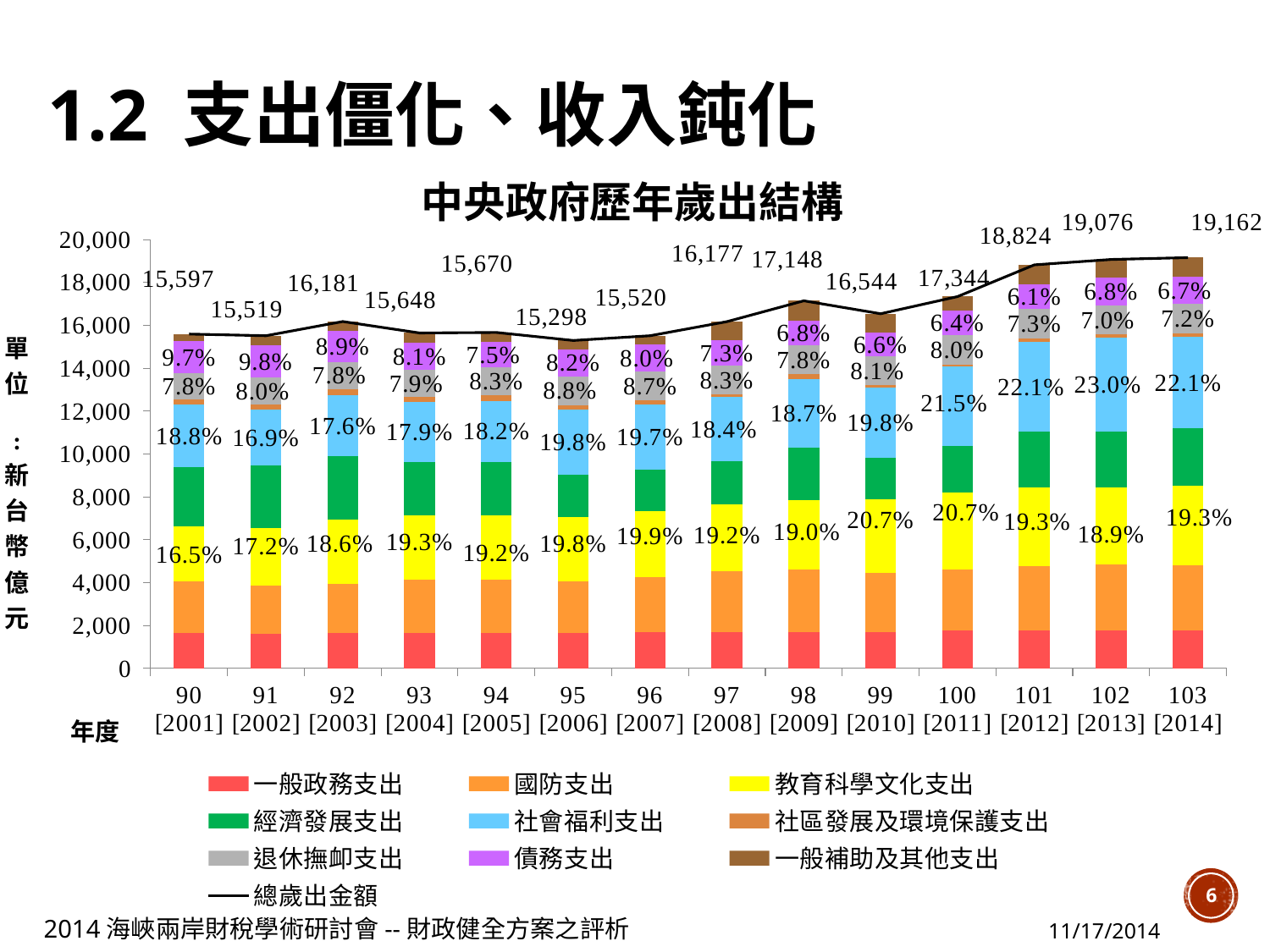
What is the difference between the total expenditure in 103 [2014] and in 90 [2001]? 3,565 What is the total expenditure (總歲出金額) shown for year 103 [2014]? 19,162 What share of expenditure does 社會福利支出 account for in year 102 [2013]? 23.0% Which year has the highest total expenditure (總歲出金額)? 103 [2014] How many entries does the legend list? 10 What kind of chart is this? Stacked bar chart with a line How many years are shown on the x axis? 14 What is the title of the chart? 中央政府歷年歲出結構 What share of expenditure does 債務支出 account for in year 90 [2001]? 9.7% Is the share of 社會福利支出 larger in year 102 [2013] or in year 91 [2002]? 102 [2013] Which year has the lowest total expenditure (總歲出金額)? 95 [2006] Does the total expenditure line generally rise or fall from year 90 [2001] to year 103 [2014]? Rise